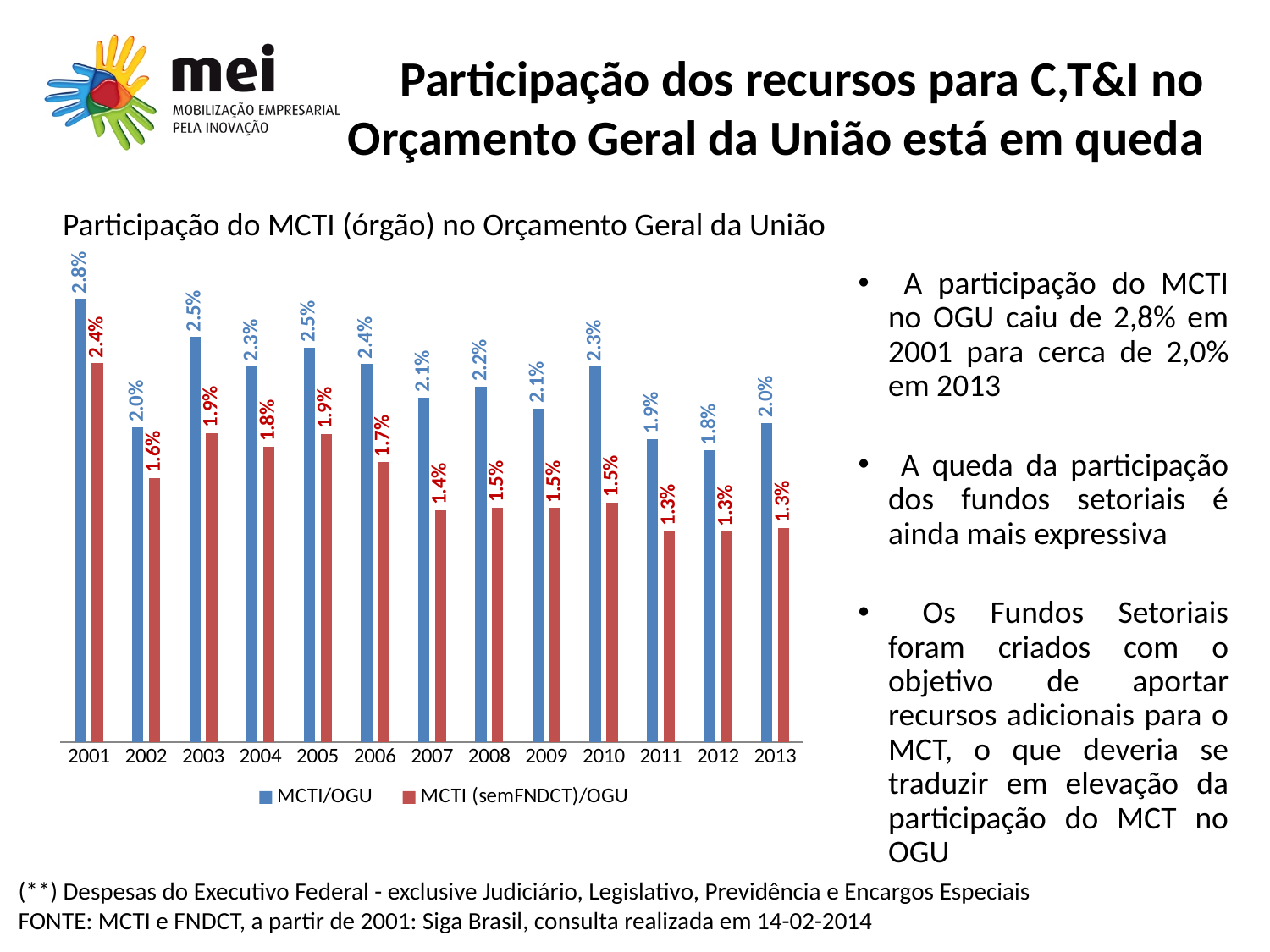
How many years are shown on the x axis of the chart? 13 In which year is the MCTI (semFNDCT)/OGU value highest? 2001 What is the MCTI/OGU value for 2008? 2.2% How many series does the chart legend list? 2 What type of chart is shown on the slide? Bar chart Which is larger, the MCTI/OGU value in 2003 or in 2010? 2003 What is the MCTI (semFNDCT)/OGU value for 2013? 1.3% What is the difference between the MCTI/OGU and MCTI (semFNDCT)/OGU values in 2013? 0.7% What is the MCTI (semFNDCT)/OGU value for 2006? 1.7% In which year is the MCTI/OGU value highest? 2001 In which year is the MCTI/OGU value lowest? 2012 What is the MCTI/OGU value for 2001? 2.8%